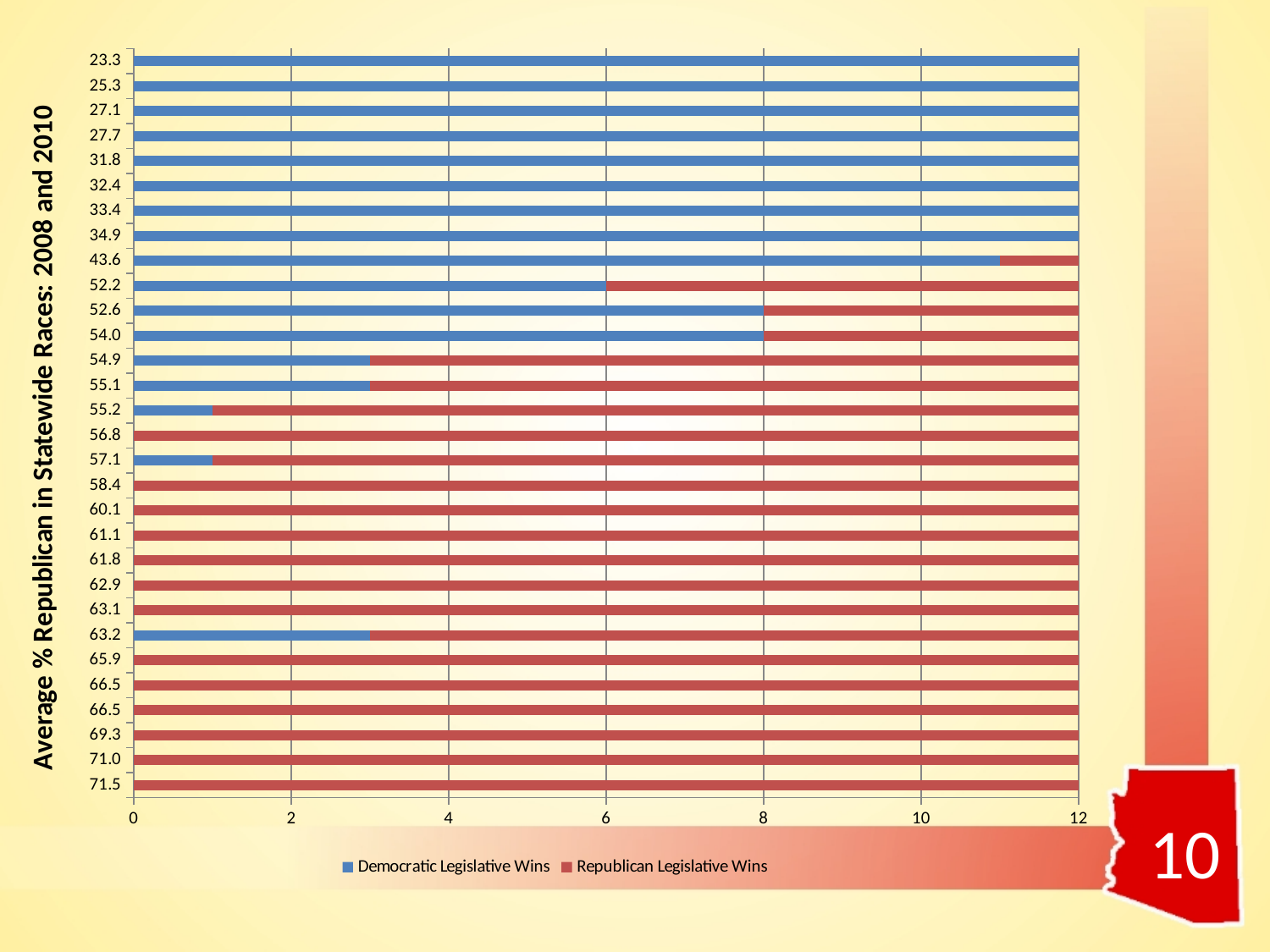
Which has more Democratic Legislative Wins, the 52.2 category or the 55.2 category? 52.2 How many categories (bars) are plotted on the chart? 30 What is the value of Republican Legislative Wins for the 71.5 category? 12 Is the value of Democratic Legislative Wins for the 43.6 category greater or less than 10? greater What are the two series named in the legend? Democratic Legislative Wins and Republican Legislative Wins What kind of chart is shown on the slide? bar chart What is the value of Democratic Legislative Wins for the 52.6 category? 8 What is the value of Democratic Legislative Wins for the 23.3 category? 12 What is the value of Democratic Legislative Wins for the 52.2 category? 6 Is the value of Democratic Legislative Wins for the 54.9 category greater or less than 4? less How many series does the legend list? 2 What is the total of the stacked bar for the 52.2 category? 12